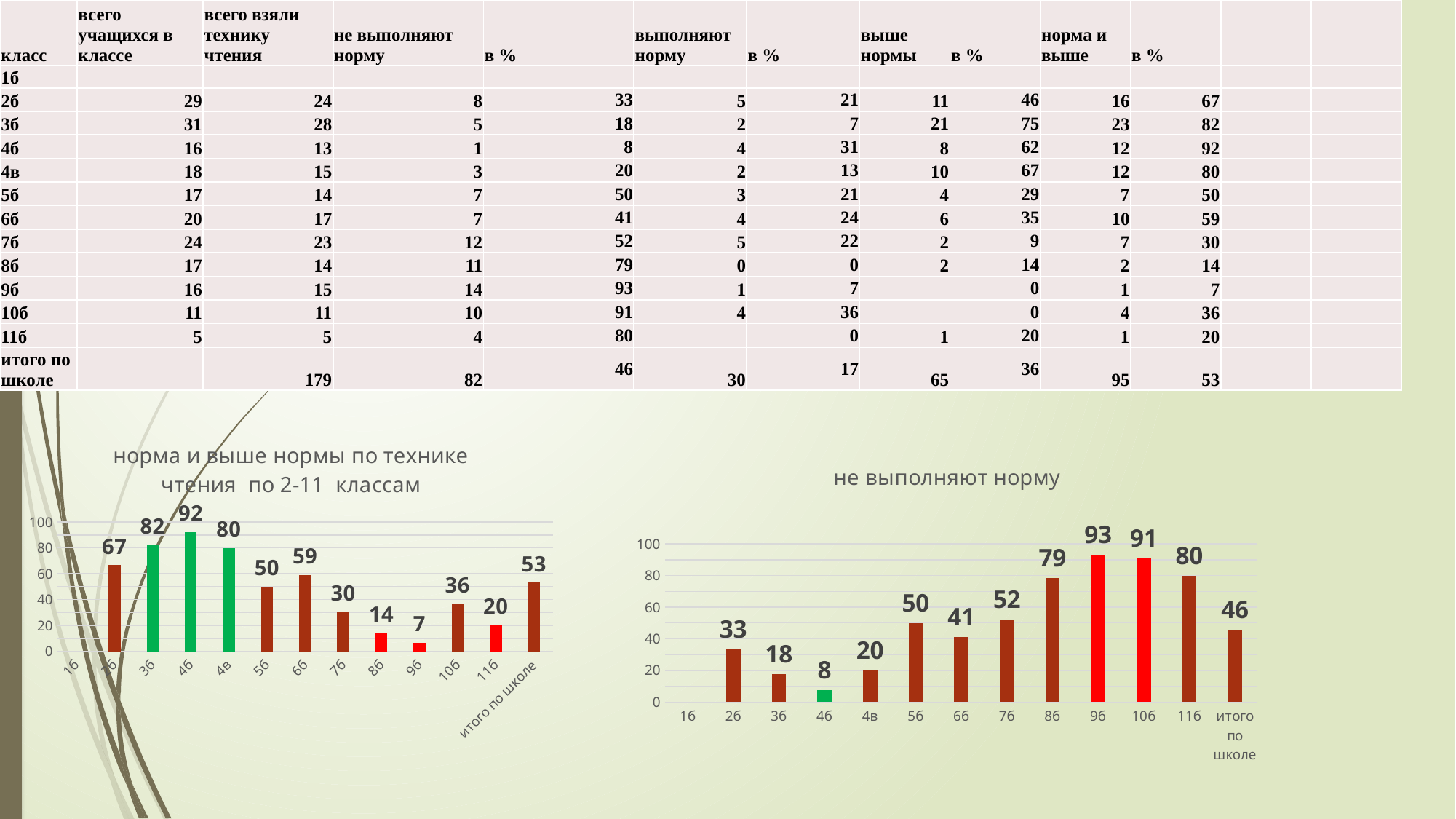
In the chart titled "не выполняют норму", what is the value for 9б? 93 In the chart titled "не выполняют норму", what is the value for "итого по школе"? 46 In the chart titled "норма и выше нормы по технике чтения по 2-11 классам", what is the value for 4б? 92 In the chart titled "не выполняют норму", which category has the highest value? 9б In the chart titled "норма и выше нормы по технике чтения по 2-11 классам", which is larger, the value for 3б or the value for 4в? 3б What kind of chart is the chart titled "не выполняют норму"? bar chart In the chart titled "не выполняют норму", which category has the lowest value? 4б In the chart titled "не выполняют норму", what is the difference between the values for 8б and 2б? 46 In the chart titled "не выполняют норму", which is larger, the value for 5б or the value for 6б? 5б How many categories are listed on the x axis of the chart titled "не выполняют норму"? 13 In the chart titled "норма и выше нормы по технике чтения по 2-11 классам", which category has the lowest value? 9б In the chart titled "норма и выше нормы по технике чтения по 2-11 классам", what is the difference between the values for 4б and 11б? 72